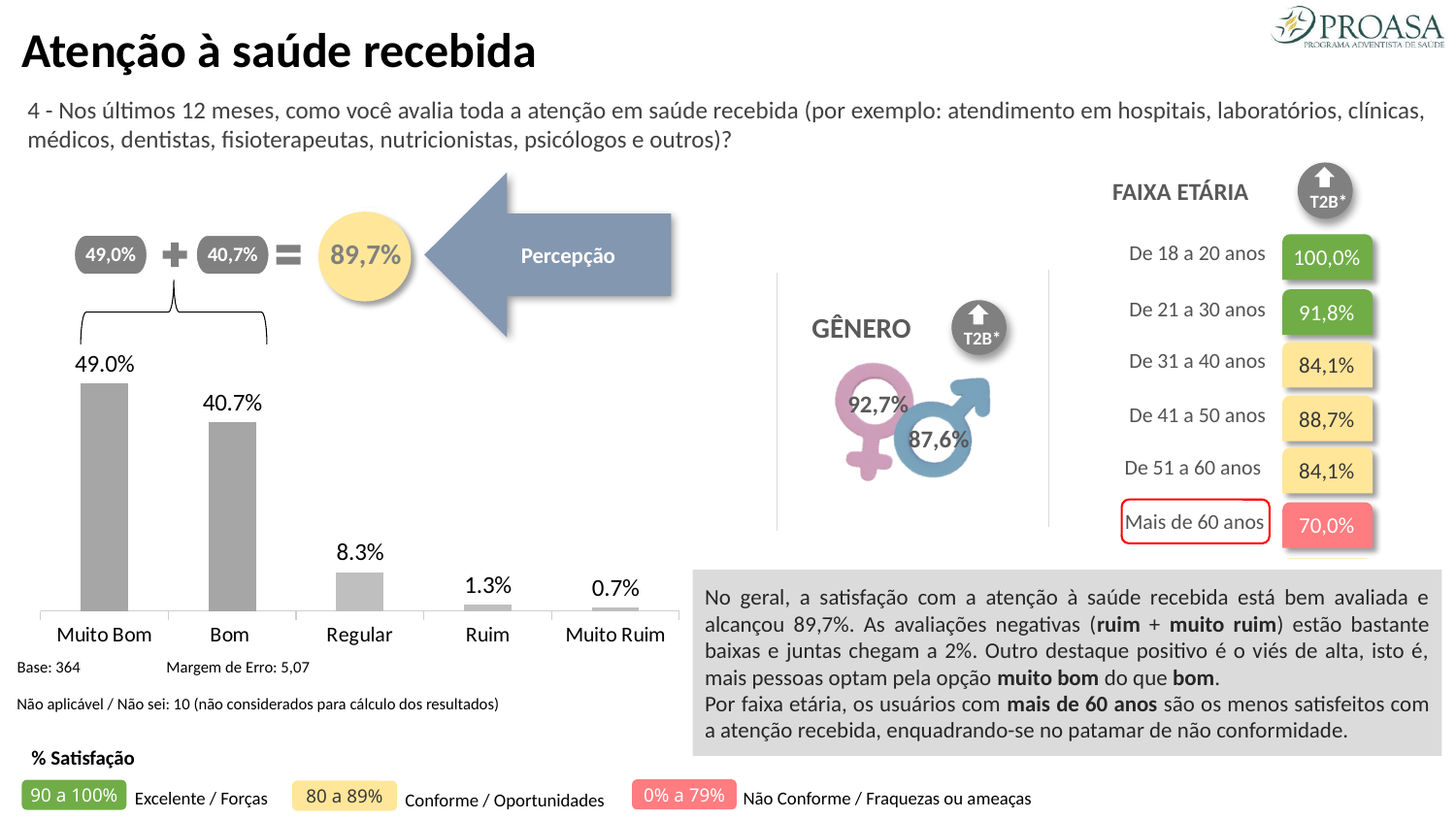
In the bar chart, what is the value for Regular? 8.3% Do the values in the bar chart rise or fall from left to right? fall In the Faixa Etária section, what is the value for De 18 a 20 anos? 100,0% In the Faixa Etária section, which age group has the lowest value? Mais de 60 anos How many categories are shown in the bar chart? 5 Which category has the highest value in the bar chart? Muito Bom In the bar chart, what is the value for Muito Bom? 49.0% What type of chart is used to show the ratings from Muito Bom to Muito Ruim? bar chart Which category has the lowest value in the bar chart? Muito Ruim In the bar chart, which is larger: the value for Regular or the value for Ruim? Regular In the bar chart, what is the value for Muito Ruim? 0.7% In the bar chart, what is the difference between the values for Muito Bom and Bom? 8.3%